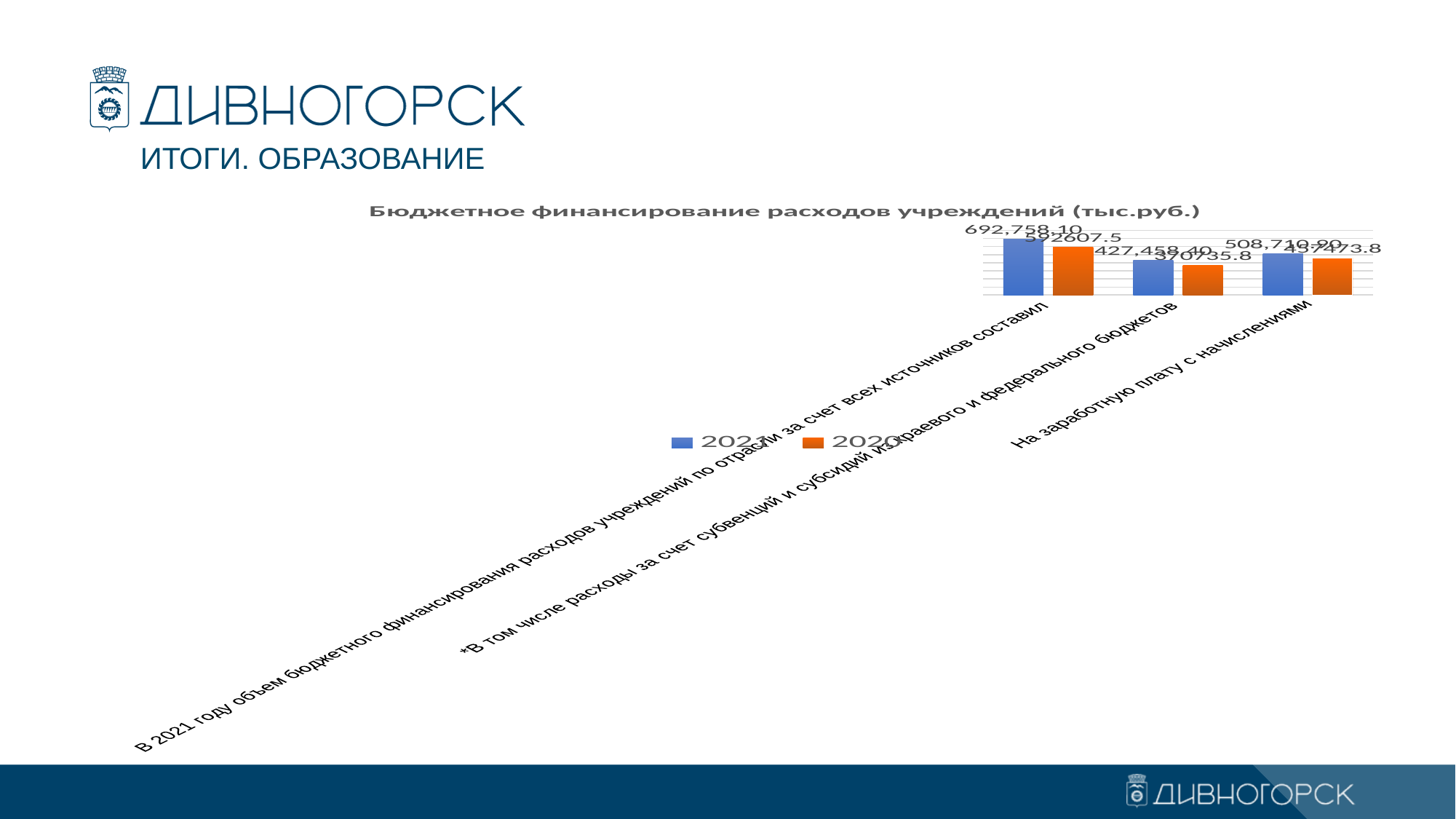
What kind of chart is shown on the slide? bar chart What is the 2021 value for the category 'На заработную плату с начислениями'? 508,710.90 What is the 2020 value for the total budget financing from all sources (first category)? 592607.5 What is the title of the chart? Бюджетное финансирование расходов учреждений (тыс.руб.) Which category has the highest 2021 value? В 2021 году объем бюджетного финансирования расходов учреждений по отрасли за счет всех источников составил How many categories are shown on the chart? 3 Which is larger for 'На заработную плату с начислениями': the 2021 value or the 2020 value? 2021 What is the 2021 value for the total budget financing from all sources (first category)? 692,758.10 What is the difference between the 2021 and 2020 values for 'На заработную плату с начислениями'? 51,237.1 What is the 2020 value for the category 'На заработную плату с начислениями'? 457473.8 What is the 2020 value for expenses funded by subventions and subsidies from regional and federal budgets? 370735.8 How many series does the chart legend list? 2